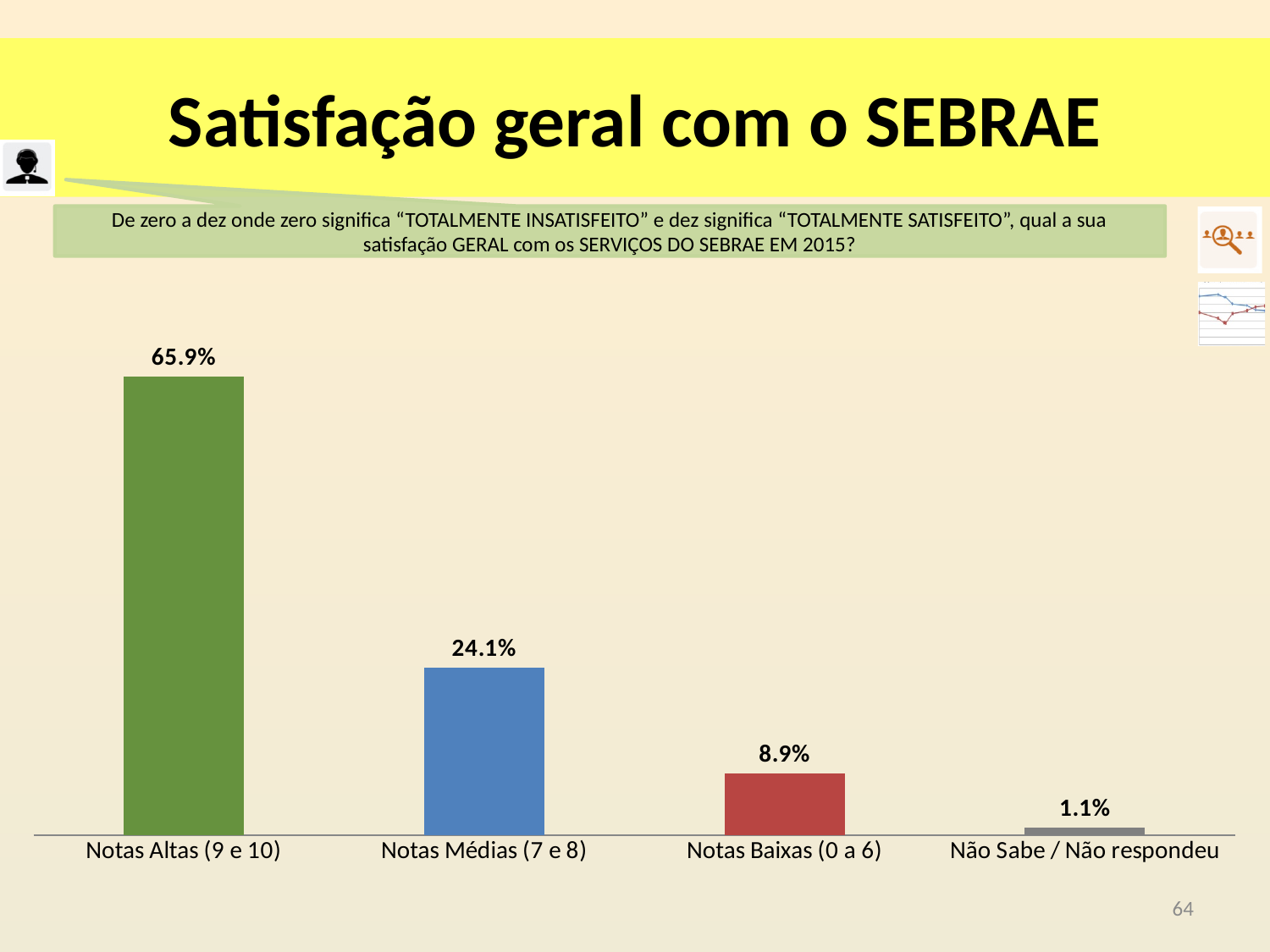
How many categories are shown in the chart? 4 What is the value for Não Sabe / Não respondeu? 1.1% What is the value for Notas Médias (7 e 8)? 24.1% What is the value for Notas Altas (9 e 10)? 65.9% What kind of chart is shown on the slide? Bar chart What is the title of the slide containing the chart? Satisfação geral com o SEBRAE Which category has the lowest value? Não Sabe / Não respondeu What is the difference between the values for Notas Altas (9 e 10) and Notas Médias (7 e 8)? 41.8% What is the value for Notas Baixas (0 a 6)? 8.9% Which category has the highest value? Notas Altas (9 e 10) Which is larger, the value for Notas Médias (7 e 8) or the value for Notas Baixas (0 a 6)? Notas Médias (7 e 8) What is the difference between the values for Notas Baixas (0 a 6) and Não Sabe / Não respondeu? 7.8%